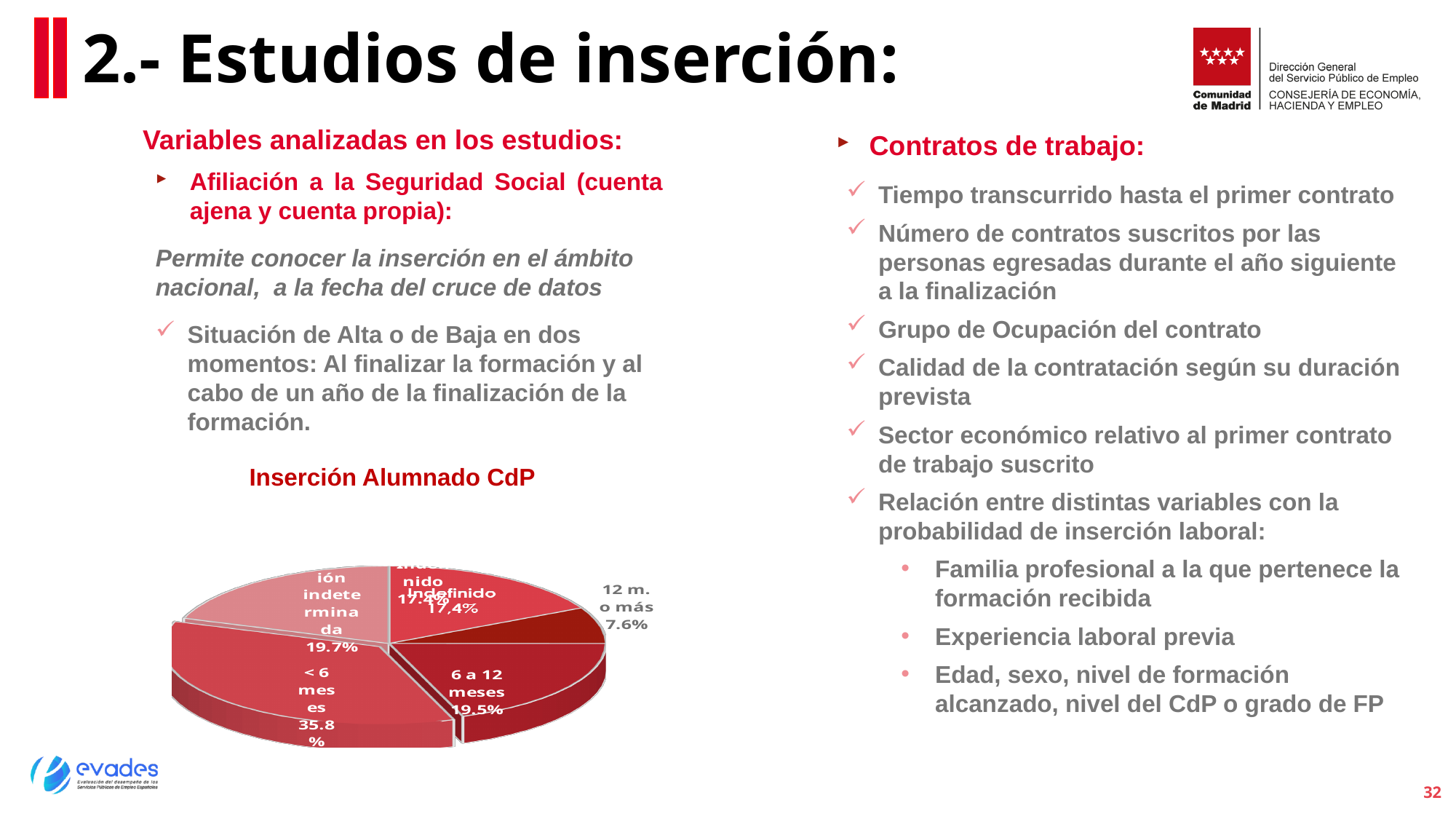
In the 'Inserción Alumnado CdP' pie chart, which slice is larger: '< 6 meses' or 'Indefinido'? < 6 meses In the 'Inserción Alumnado CdP' pie chart, what percentage is shown for '12 m. o más'? 7.6% Which slice of the 'Inserción Alumnado CdP' pie chart is the largest? < 6 meses In the 'Inserción Alumnado CdP' pie chart, what percentage is shown for '6 a 12 meses'? 19.5% In the 'Inserción Alumnado CdP' pie chart, what is the difference in percentage points between '< 6 meses' and '6 a 12 meses'? 16.3 percentage points What kind of chart is shown under the title 'Inserción Alumnado CdP'? Pie chart In the 'Inserción Alumnado CdP' pie chart, which slice is larger: '6 a 12 meses' or '12 m. o más'? 6 a 12 meses In the 'Inserción Alumnado CdP' pie chart, what is the difference in percentage points between '6 a 12 meses' and '12 m. o más'? 11.9 percentage points In the 'Inserción Alumnado CdP' pie chart, what percentage is shown for '< 6 meses'? 35.8% What is the title of the pie chart on the slide? Inserción Alumnado CdP How many slices does the 'Inserción Alumnado CdP' pie chart have? 5 Which slice of the 'Inserción Alumnado CdP' pie chart is the smallest? 12 m. o más